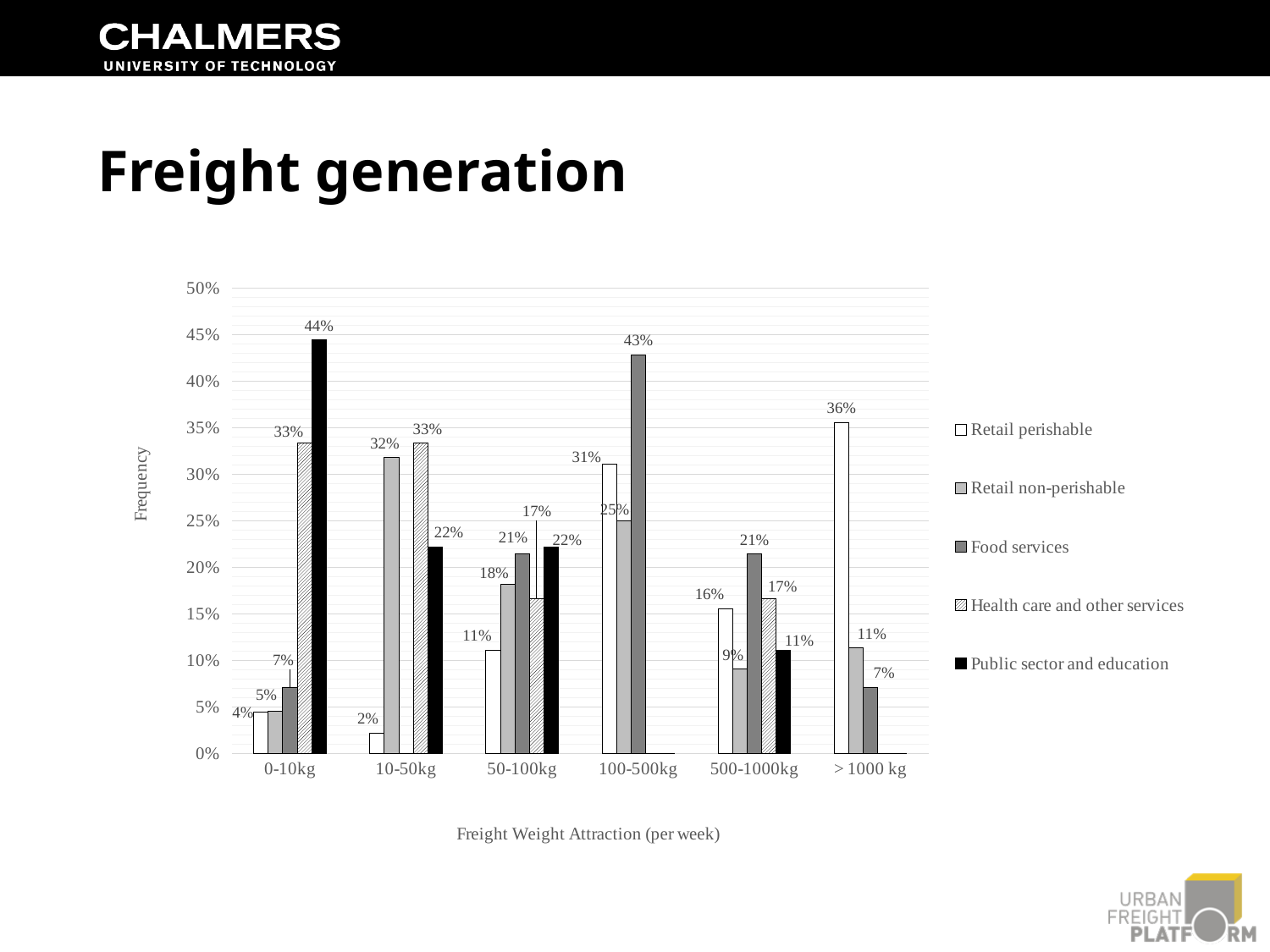
In the 50-100kg category, which is larger: Food services or Retail non-perishable? Food services What is the value for Retail perishable in the > 1000 kg category? 36% Which series has the highest value in the 500-1000kg category? Food services What kind of chart is shown on the slide? Bar chart How many series does the legend list? 5 What is the value for Food services in the 100-500kg category? 43% What is the value for Public sector and education in the 0-10kg category? 44% How many weight categories are shown on the x axis? 6 In which weight category is the Retail perishable value lowest? 10-50kg What is the value for Retail non-perishable in the 10-50kg category? 32% In which weight category is the Retail perishable value highest? > 1000 kg In the 0-10kg category, how much higher is Public sector and education than Health care and other services? 11 percentage points